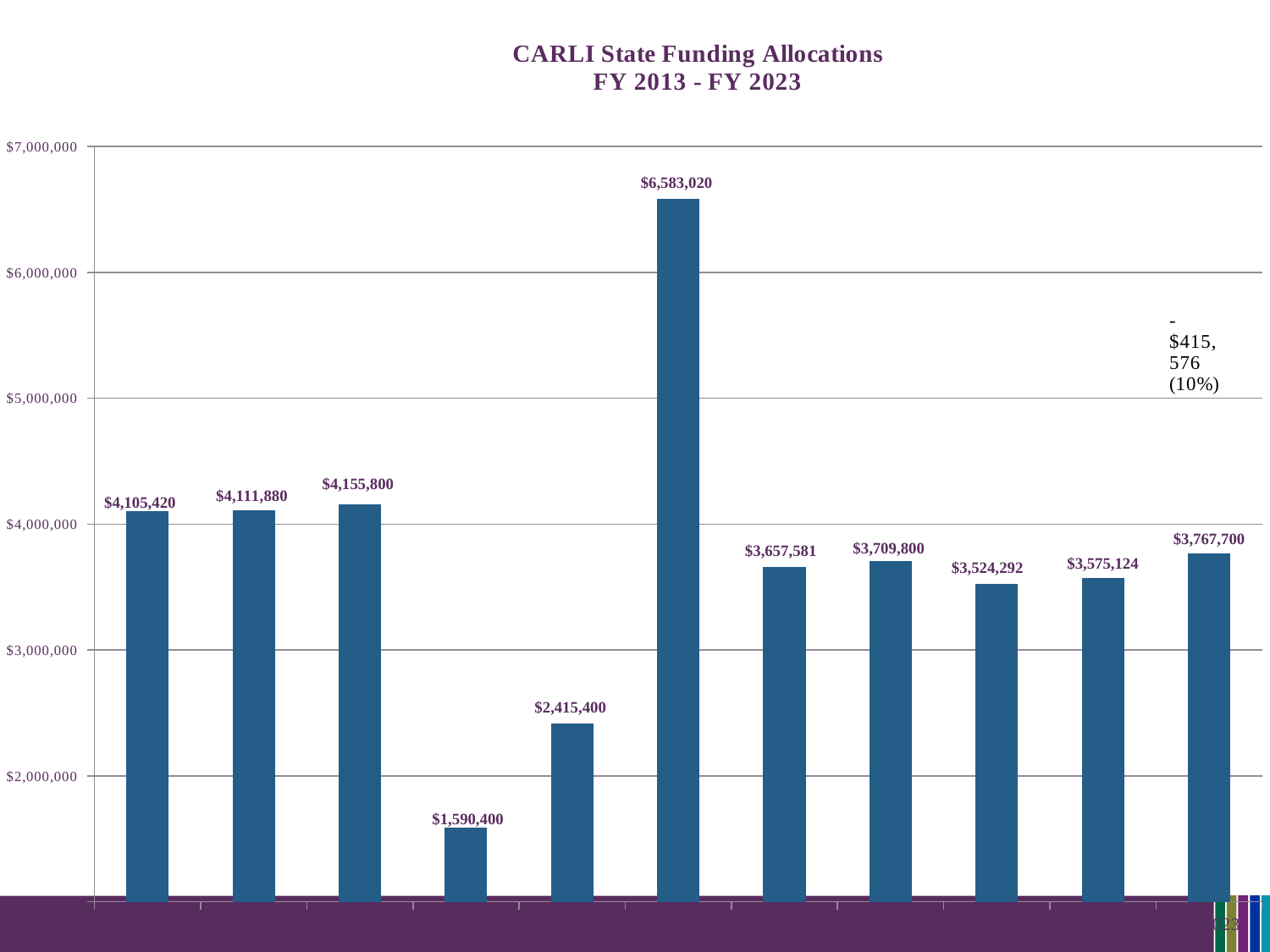
How many bars are plotted in the chart? 11 What kind of chart is shown on the slide? bar chart Is the value of the fourth bar from the left greater or less than $2,000,000? less Which is larger, the first bar ($4,105,420) or the last bar ($3,767,700)? the first bar ($4,105,420) What text annotation appears at the upper right of the plot area? -$415,576 (10%) What is the value shown on the first (leftmost) bar? $4,105,420 What is the value shown on the fifth bar from the left? $2,415,400 What is the difference between the tallest bar ($6,583,020) and the shortest bar ($1,590,400)? $4,992,620 What is the value of the tallest bar in the chart? $6,583,020 What is the value shown on the last (rightmost) bar? $3,767,700 What is the value of the shortest bar in the chart? $1,590,400 What is the title of the chart? CARLI State Funding Allocations FY 2013 - FY 2023